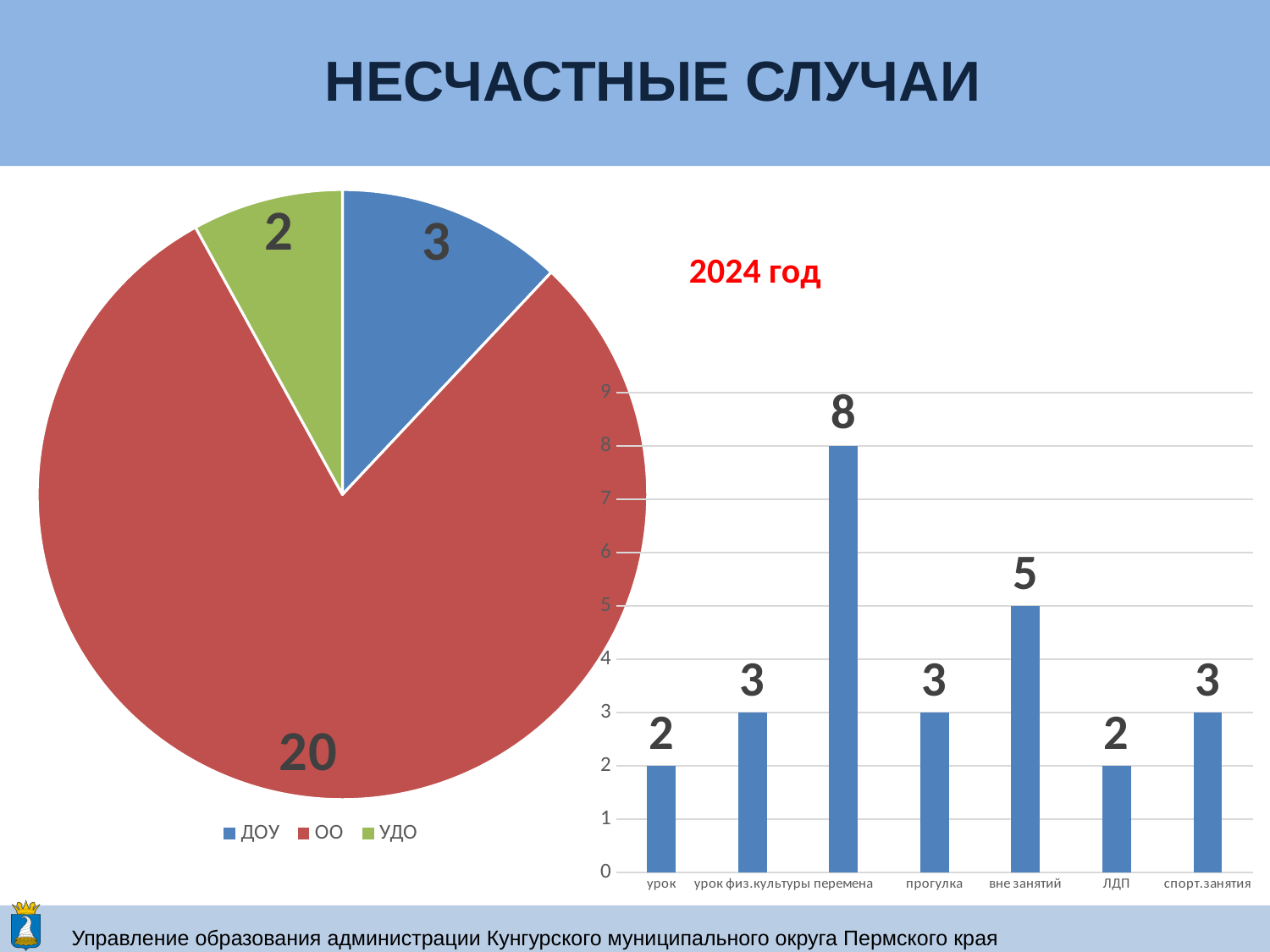
In the pie chart on the left, what is the value for ДОУ? 3 In the pie chart on the left, what colour is the ОО slice? Red What kind of chart is shown on the right side of the slide? Bar chart In the pie chart on the left, what is the value for ОО? 20 In the pie chart on the left, which category has the smallest slice? УДО In the bar chart on the right, what is the value for перемена? 8 In the bar chart on the right, how many categories are shown on the x axis? 7 In the bar chart on the right, what is the value for вне занятий? 5 In the pie chart on the left, what is the difference between the values for ОО and ДОУ? 17 In the bar chart on the right, which category has the highest value? перемена In the bar chart on the right, what is the difference between the values for перемена and вне занятий? 3 In the pie chart on the left, how many categories does the legend list? 3